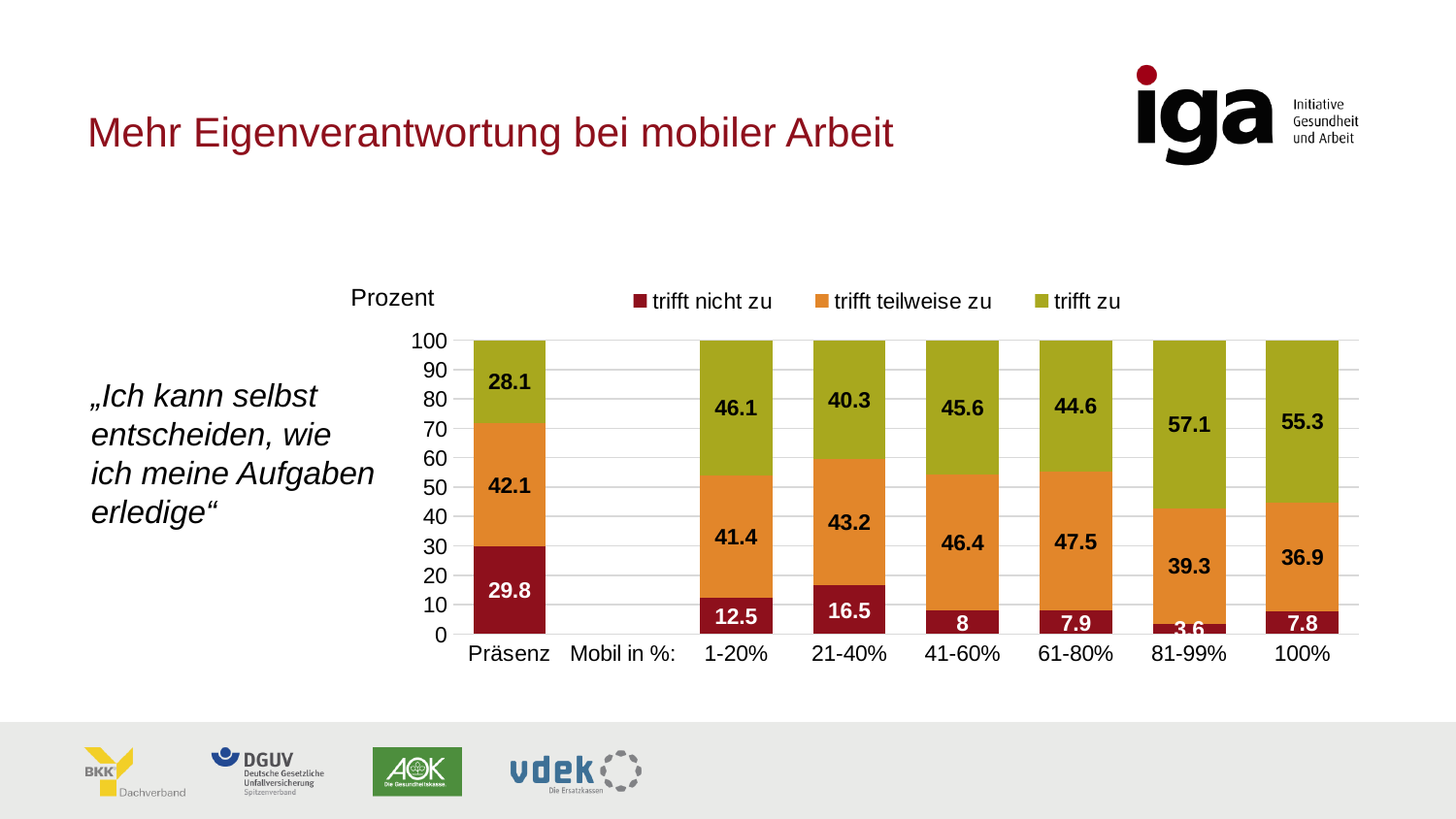
Which is larger: the 'trifft teilweise zu' value for 21-40% or for 100%? 21-40% What is the total of the stacked bar for 41-60%? 100 What is the difference between the 'trifft zu' values for 100% and 1-20%? 9.2 How many bars are plotted in the chart? 7 What type of chart is shown on the slide? stacked bar chart What is the label of the vertical axis? Prozent Which category has the lowest 'trifft zu' value? Präsenz Which category has the highest 'trifft nicht zu' value? Präsenz How many series does the legend list? 3 What is the value of 'trifft zu' for the 81-99% bar? 57.1 What is the value of 'trifft nicht zu' for the Präsenz bar? 29.8 What is the value of 'trifft teilweise zu' for the 61-80% bar? 47.5